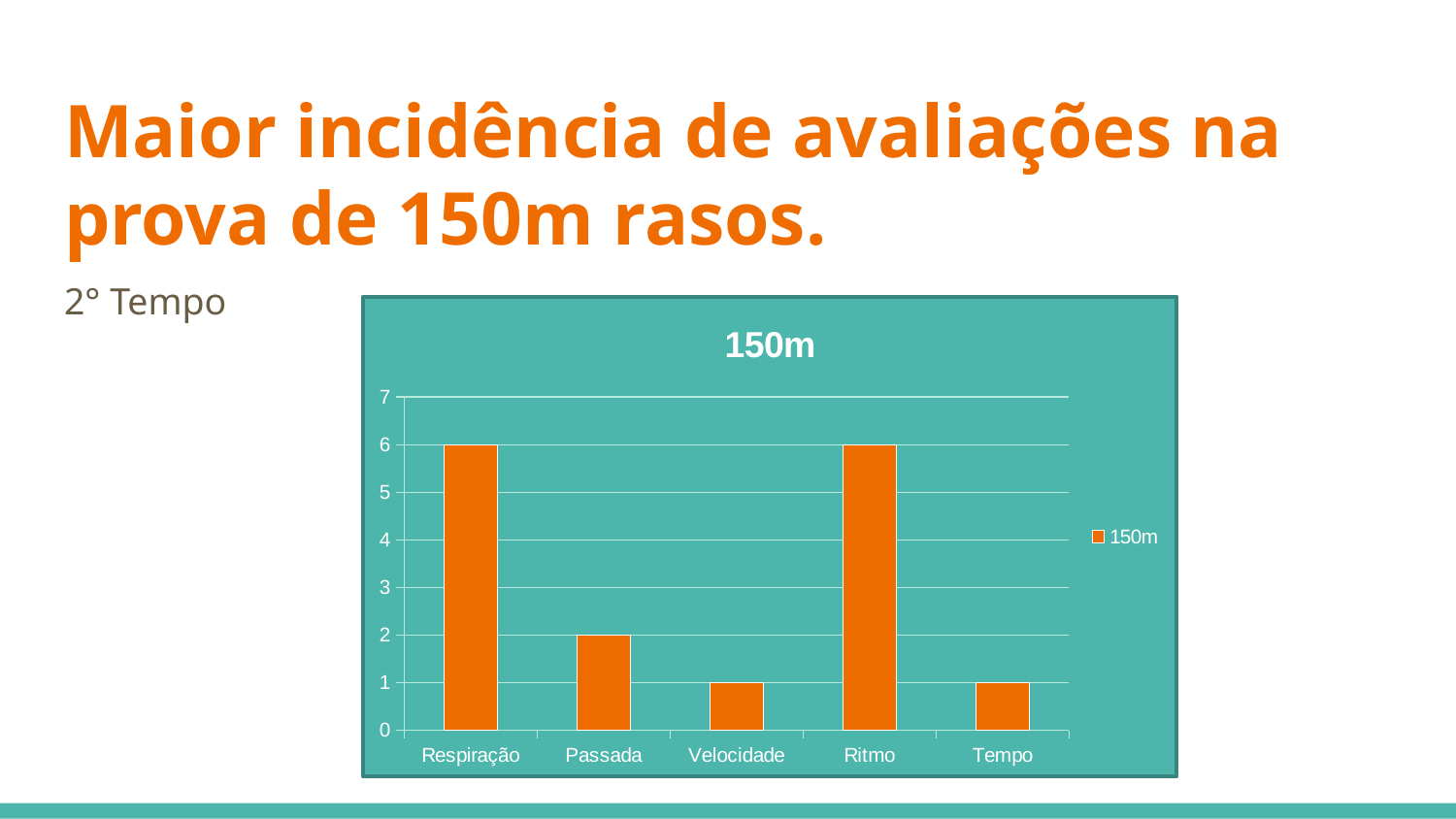
What is the value for Velocidade in the 150m chart? 1 What is the value for Passada in the 150m chart? 2 How many series does the chart legend list? 1 What is the value for Respiração in the 150m chart? 6 What is the value for Tempo in the 150m chart? 1 Which has a larger value, Passada or Velocidade? Passada What kind of chart is shown on the slide? bar chart Is the value for Ritmo greater or less than 5? greater What is the title of the chart? 150m How many categories are shown on the x axis of the chart? 5 What is the value for Ritmo in the 150m chart? 6 What is the difference between the values for Respiração and Passada? 4